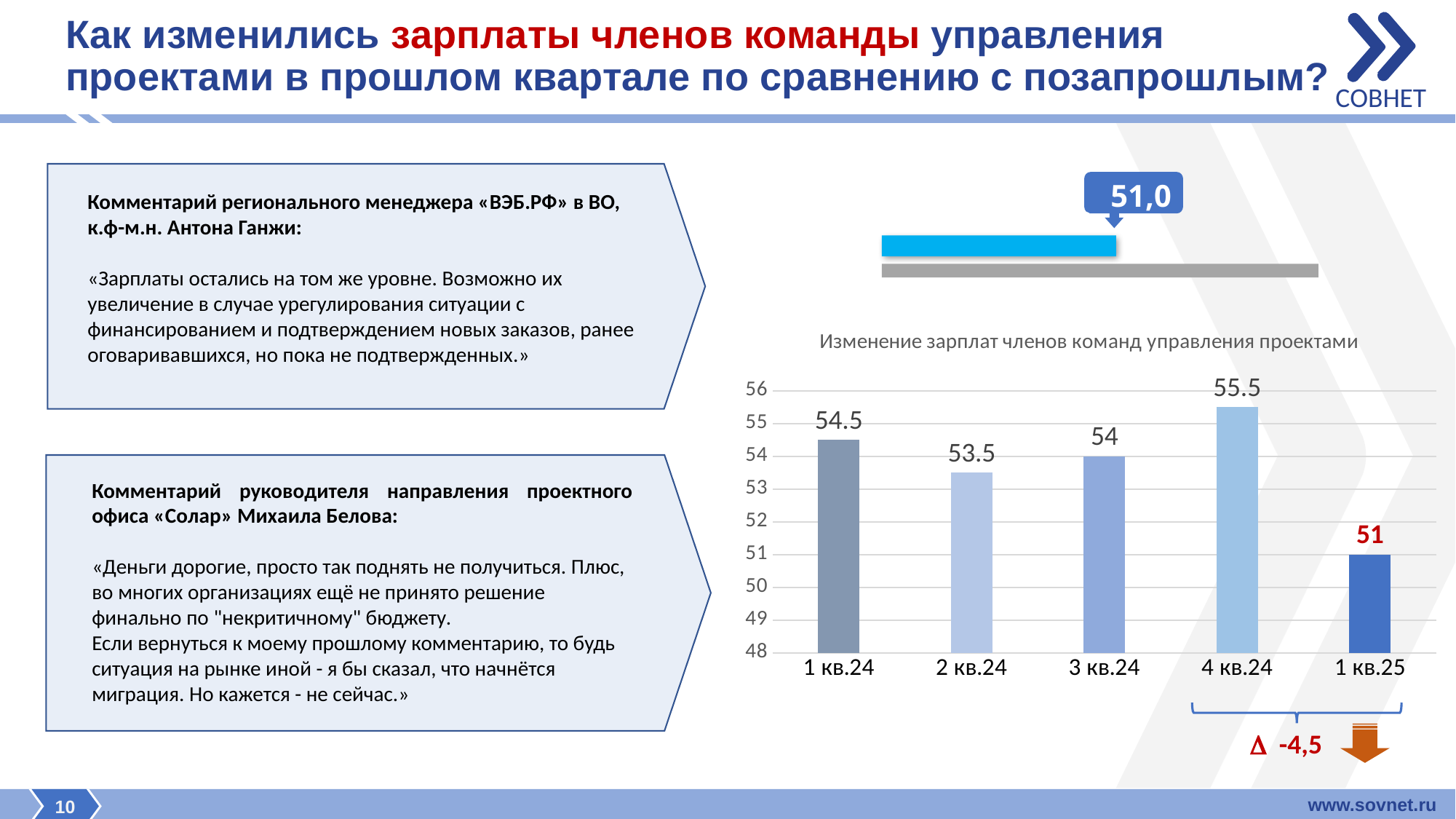
What type of chart is shown on the slide? bar chart What is the value for 3 кв.24? 54 What is the value for 1 кв.24? 54.5 What is the difference between the values for 4 кв.24 and 1 кв.25? 4.5 How many categories (quarters) are shown on the x axis of the chart? 5 Which quarter has the lowest value? 1 кв.25 What is the value for 2 кв.24? 53.5 Which quarter has the highest value? 4 кв.24 Which is larger, the value for 1 кв.24 or the value for 2 кв.24? 1 кв.24 What is the value for 4 кв.24? 55.5 What is the title of the chart on the slide? Изменение зарплат членов команд управления проектами What is the value for 1 кв.25? 51